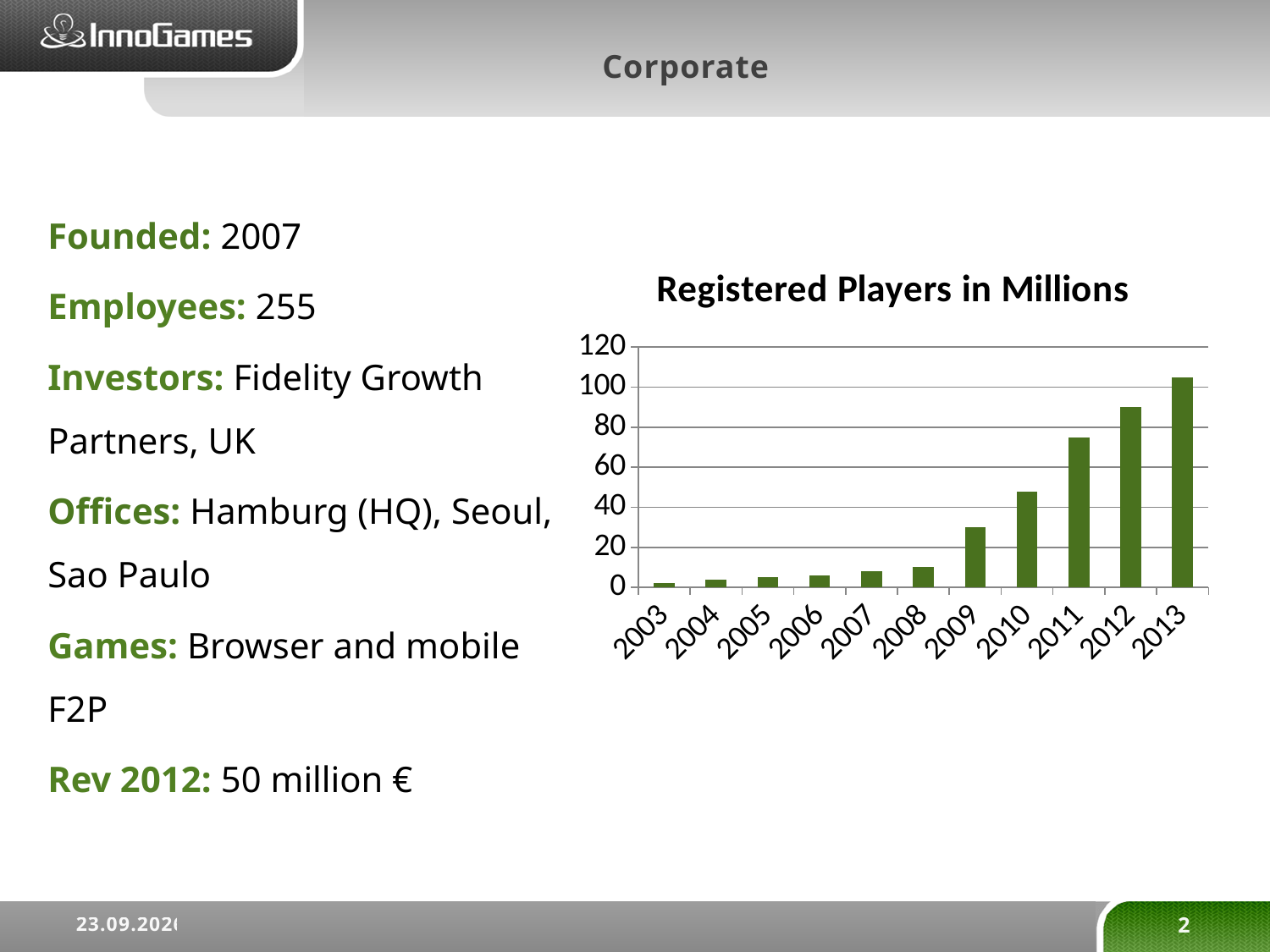
Is the value for 2012 greater or less than 80? greater Is the value for 2013 greater or less than 100? greater Which year has more registered players, 2010 or 2011? 2011 Is the value for 2008 greater or less than 20? less How many years are shown on the x axis of the chart? 11 What type of chart is shown on the slide? bar chart Which year has the lowest number of registered players? 2003 What is the title of the chart? Registered Players in Millions Do the values rise or fall from 2003 to 2013? rise Which year has the highest number of registered players? 2013